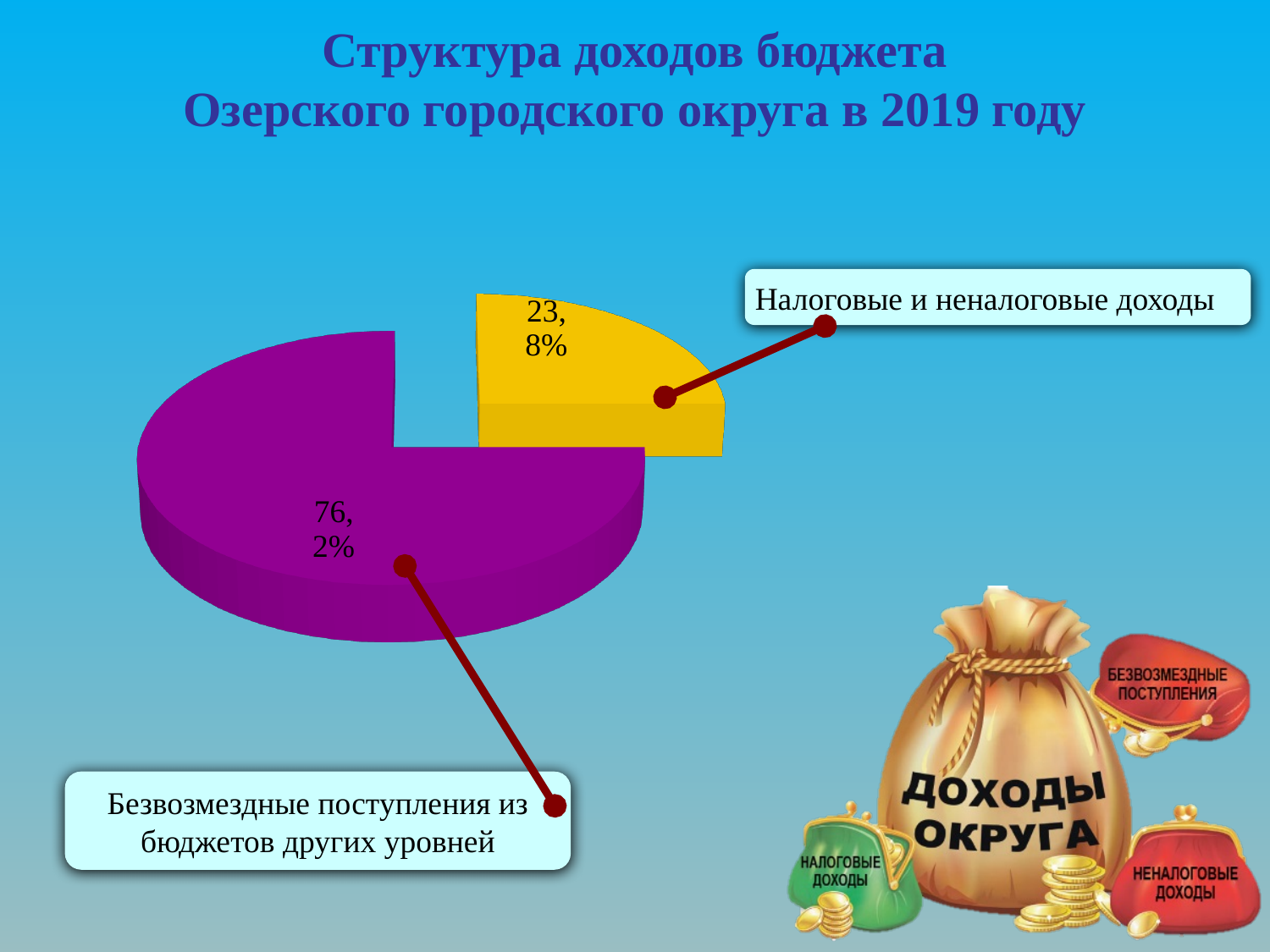
What colour is the slice for "Налоговые и неналоговые доходы"? yellow What kind of chart is shown on the slide? pie chart What is the total of the two slice percentages shown on the pie chart? 100% Which is larger: the share for "Налоговые и неналоговые доходы" or the share for "Безвозмездные поступления из бюджетов других уровней"? Безвозмездные поступления из бюджетов других уровней How many slices does the pie chart have? 2 What share of the pie does the slice labelled "Безвозмездные поступления из бюджетов других уровней" represent? 76,2% What share of the pie does the slice labelled "Налоговые и неналоговые доходы" represent? 23,8% Which slice of the pie is the largest? Безвозмездные поступления из бюджетов других уровней What colour is the slice for "Безвозмездные поступления из бюджетов других уровней"? purple What is the difference in percentage points between the "Безвозмездные поступления из бюджетов других уровней" slice and the "Налоговые и неналоговые доходы" slice? 52,4 Which slice of the pie is the smallest? Налоговые и неналоговые доходы